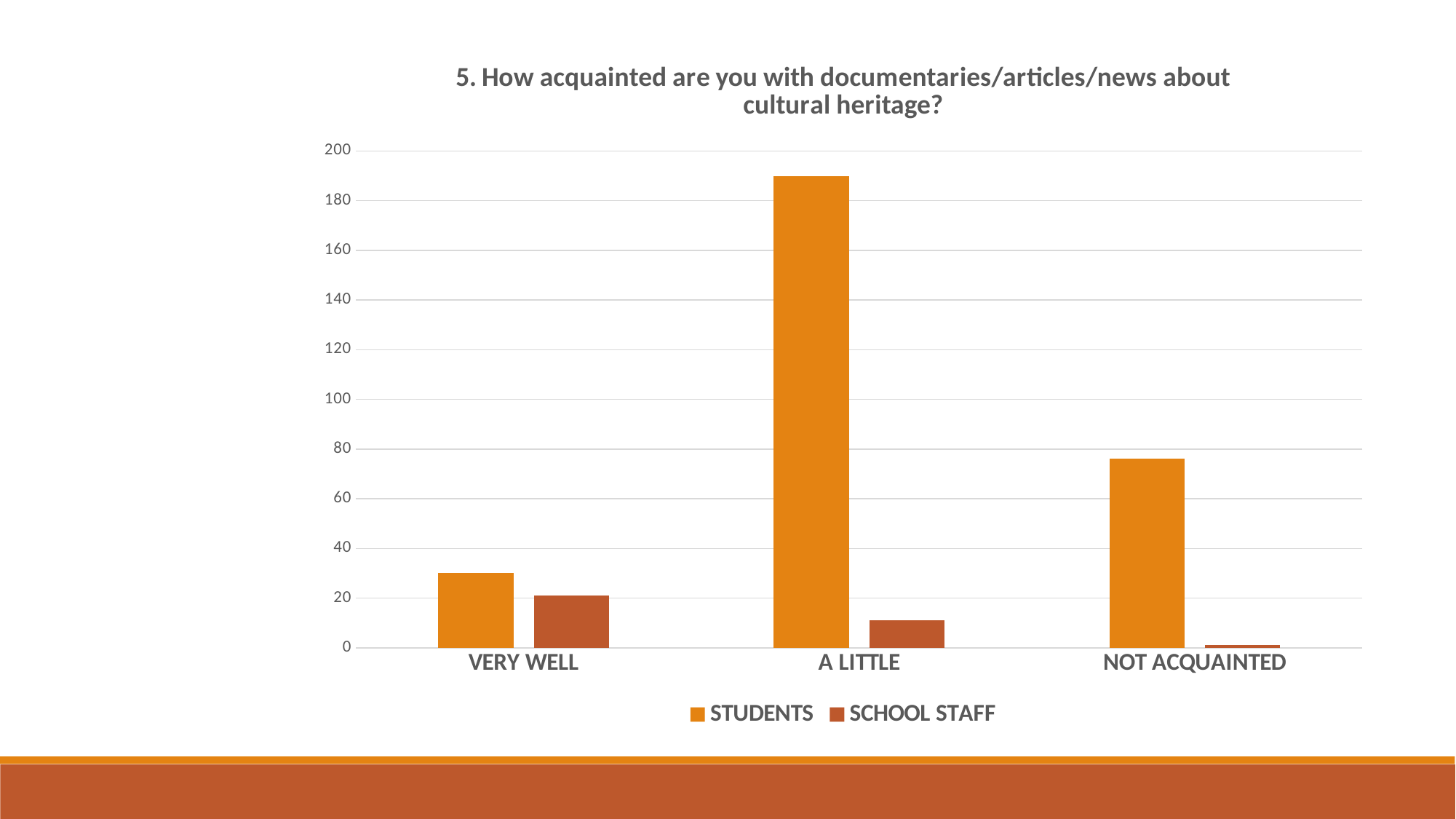
Is the STUDENTS value for NOT ACQUAINTED greater or less than 80? less What is the title of the chart? 5. How acquainted are you with documentaries/articles/news about cultural heritage? Which series is shown in the darker red-brown colour? SCHOOL STAFF Is the STUDENTS value for A LITTLE greater or less than 180? greater Which category has the highest value for STUDENTS? A LITTLE Which category has the highest value for SCHOOL STAFF? VERY WELL How many series does the legend list? 2 How many categories are shown on the x axis? 3 Is the SCHOOL STAFF value for VERY WELL greater or less than 40? less What kind of chart is shown on the slide? bar chart Which category has the lowest value for SCHOOL STAFF? NOT ACQUAINTED Which is larger: the STUDENTS value for VERY WELL or the STUDENTS value for NOT ACQUAINTED? NOT ACQUAINTED